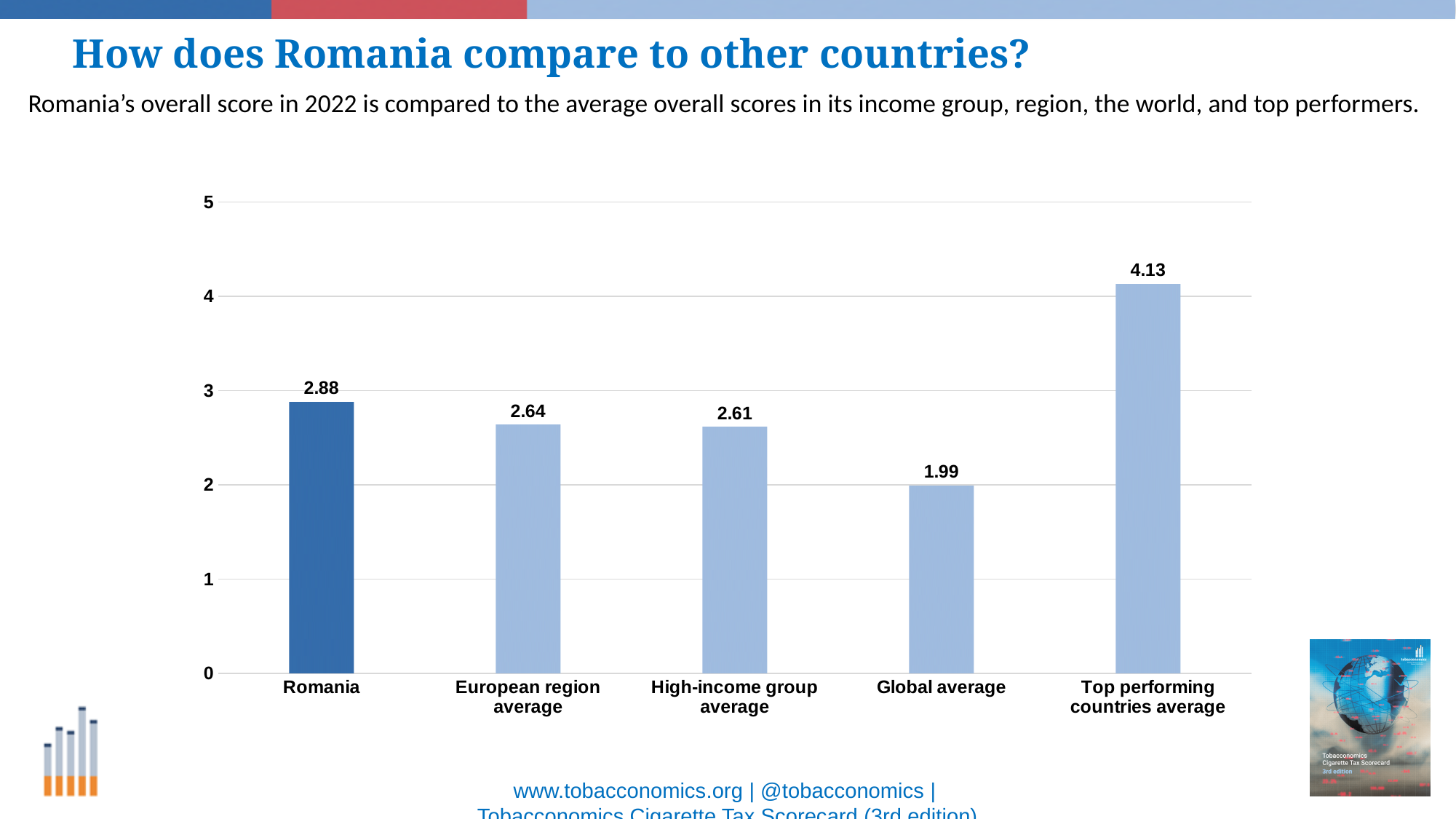
What kind of chart is shown on the slide? Bar chart What is the value for Romania? 2.88 Which category has the lowest value? Global average What is the value for the Top performing countries average? 4.13 What is the value for the High-income group average? 2.61 Which category has the highest value? Top performing countries average Is the value for the Top performing countries average greater or less than 4? greater What is the difference between the Top performing countries average and Romania? 1.25 What is the value for the Global average? 1.99 Which is larger, Romania or the Global average? Romania How many categories are shown in the chart? 5 What is the difference between Romania and the European region average? 0.24